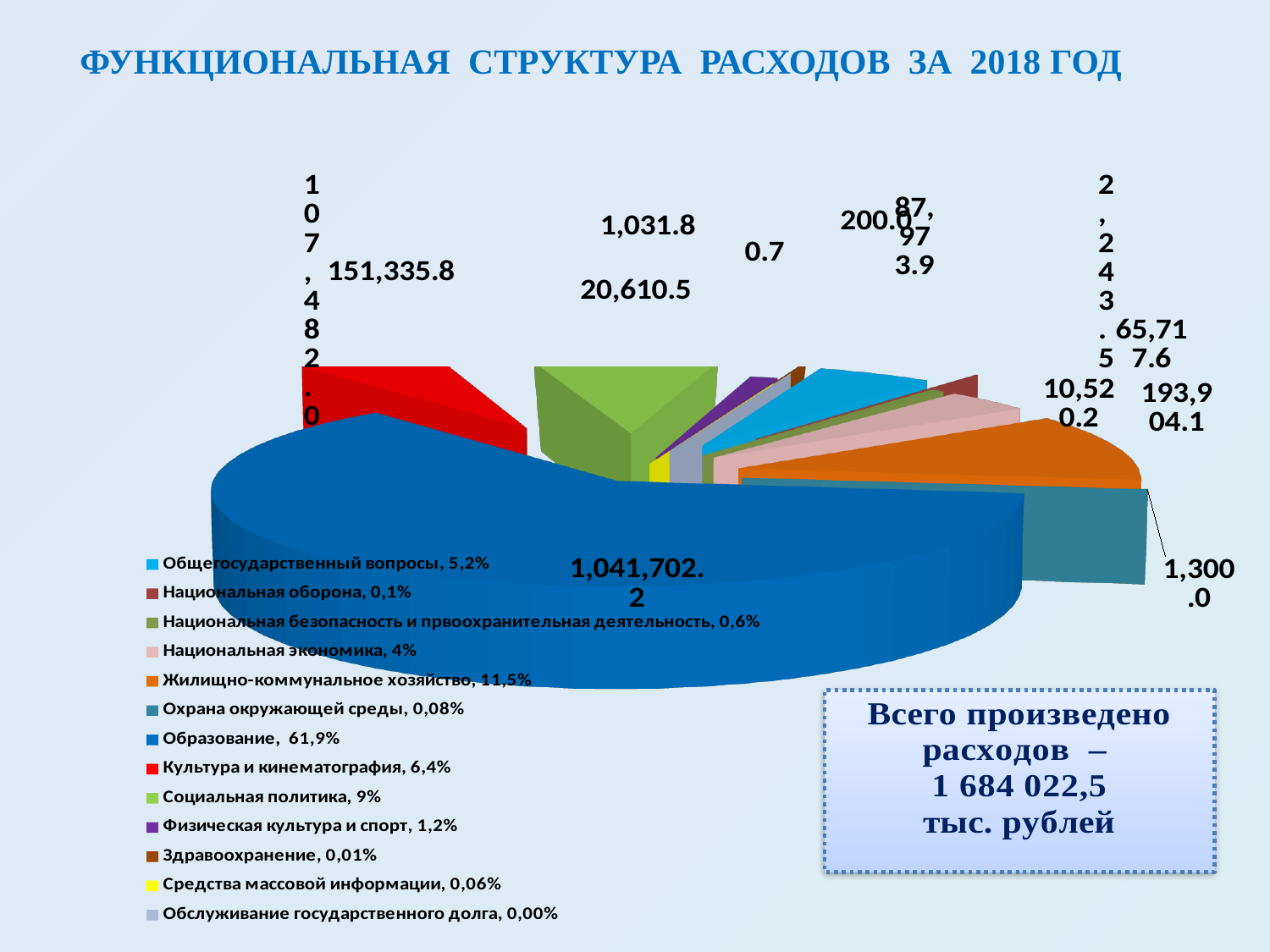
What is the data label shown on the Образование slice? 1,041,702.2 How many categories does the legend of the pie chart list? 13 What kind of chart is shown on the slide? pie chart What total amount of expenditures is stated in the text box on the slide? 1 684 022,5 тыс. рублей What is the data label for the Охрана окружающей среды slice? 1,300.0 What share of expenditures does Образование account for? 61,9% What is the difference in percentage points between the shares of Образование and Жилищно-коммунальное хозяйство? 50,4% What share of expenditures does Жилищно-коммунальное хозяйство account for? 11,5% What share of expenditures does Социальная политика account for? 9% Which category has the smallest share according to the legend? Обслуживание государственного долга Which category has the largest share of the pie? Образование Which has the larger share: Культура и кинематография or Общегосударственный вопросы? Культура и кинематография